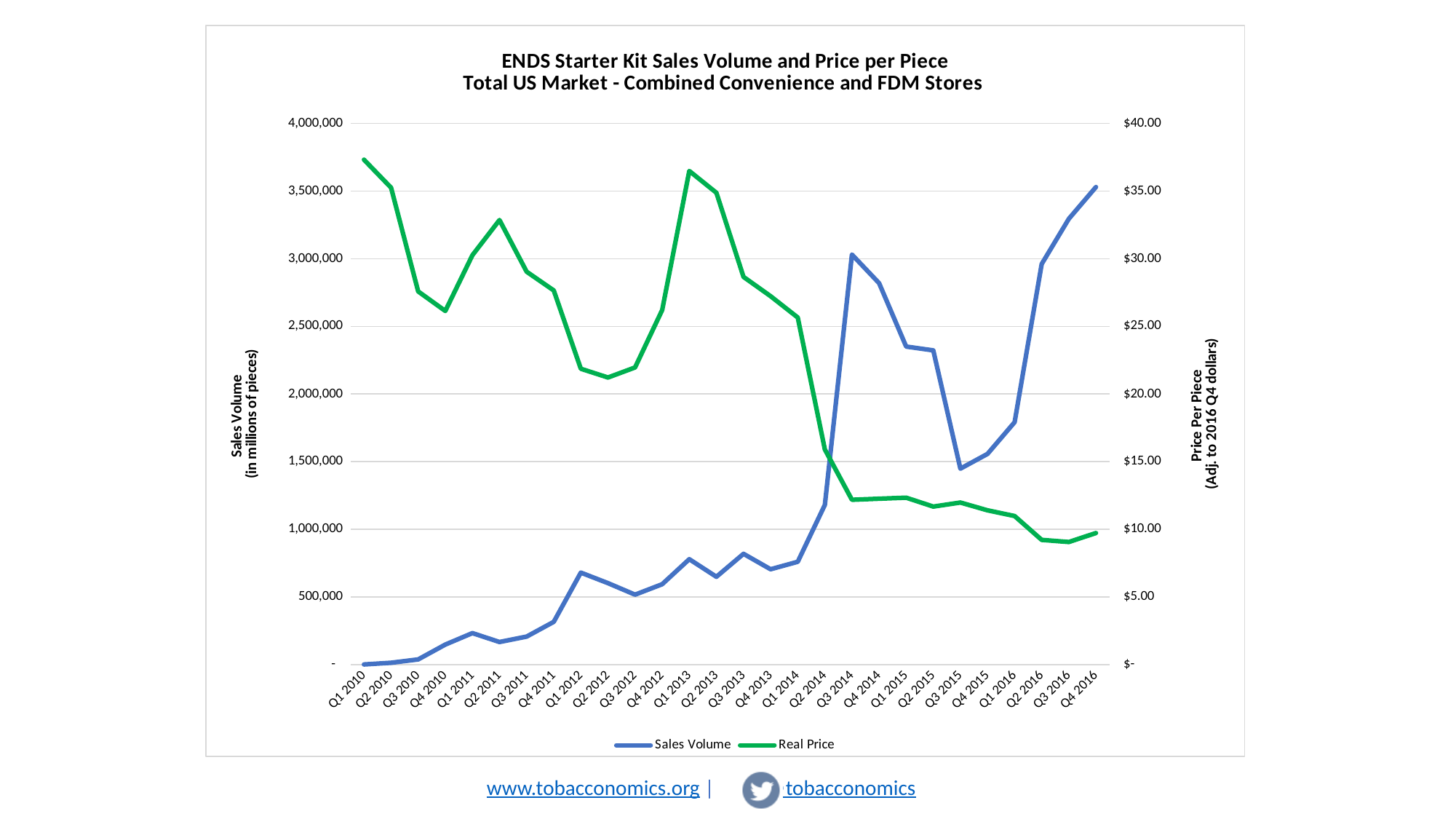
Is the Real Price for Q3 2014 greater or less than $15.00? less How many series does the legend list? 2 Which quarter has the larger Sales Volume, Q3 2014 or Q3 2015? Q3 2014 Which series is drawn in green? Real Price What kind of chart is shown on the slide? Line chart How many quarters are plotted along the x axis? 28 Is the Real Price for Q2 2012 greater or less than $25.00? less Is the Real Price for Q1 2010 greater or less than $35.00? greater Does the Real Price series generally rise or fall from Q1 2010 to Q4 2016? Fall In which quarter is Sales Volume highest? Q4 2016 In which quarter is Sales Volume lowest? Q1 2010